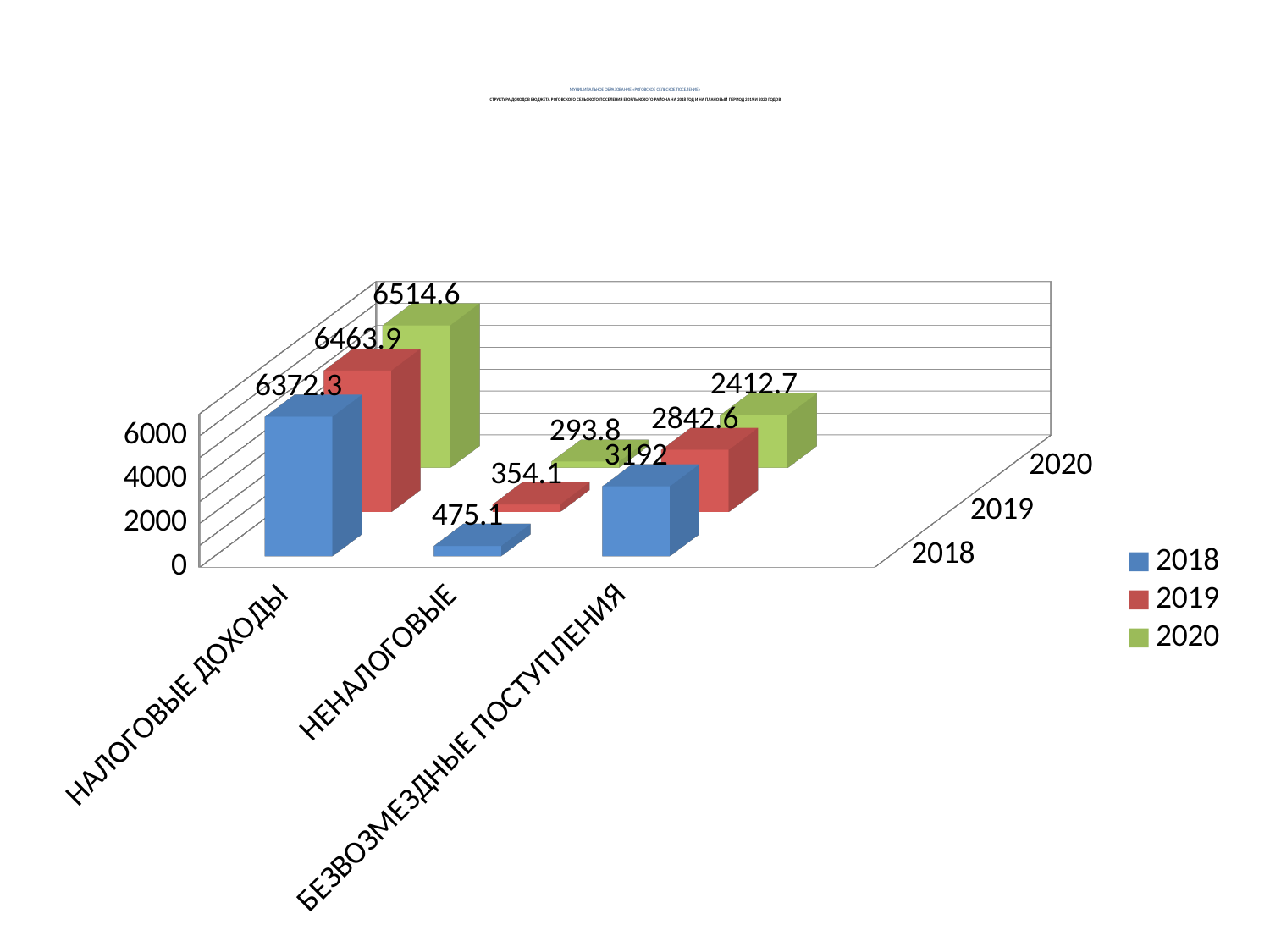
Which category has the lowest value in 2018? НЕНАЛОГОВЫЕ What is the value for НАЛОГОВЫЕ ДОХОДЫ in 2020? 6514.6 How many series does the legend list? 3 What kind of chart is shown on the slide? Bar chart What is the value for НЕНАЛОГОВЫЕ in 2020? 293.8 What is the value for БЕЗВОЗМЕЗДНЫЕ ПОСТУПЛЕНИЯ in 2019? 2842.6 Which is larger: БЕЗВОЗМЕЗДНЫЕ ПОСТУПЛЕНИЯ in 2018 or in 2020? 2018 How many categories are shown on the x axis? 3 Which category has the highest value in 2019? НАЛОГОВЫЕ ДОХОДЫ Do the values for НЕНАЛОГОВЫЕ rise or fall from 2018 to 2020? Fall What is the difference between the 2020 and 2018 values for НАЛОГОВЫЕ ДОХОДЫ? 142.3 What is the value for НАЛОГОВЫЕ ДОХОДЫ in 2018? 6372.3